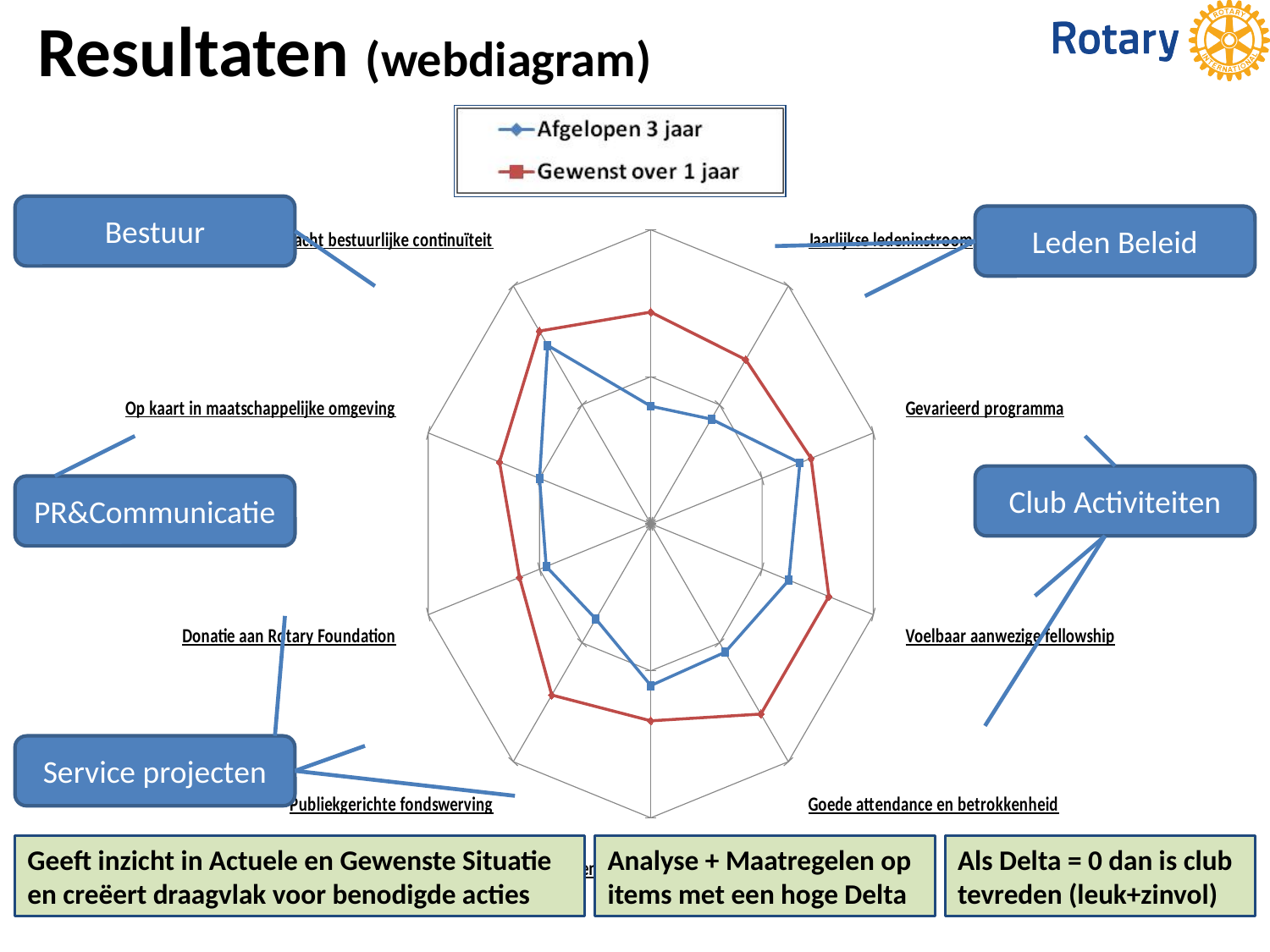
For 'Gevarieerd programma', which series has the larger value: 'Afgelopen 3 jaar' or 'Gewenst over 1 jaar'? Gewenst over 1 jaar Which colour represents the series 'Gewenst over 1 jaar'? Red For 'Op kaart in maatschappelijke omgeving', is the value for 'Afgelopen 3 jaar' larger or smaller than the value for 'Gewenst over 1 jaar'? Smaller For 'Goede attendance en betrokkenheid', which series lies further from the centre: the blue or the red series? Red (Gewenst over 1 jaar) How many series does the chart legend list? 2 What kind of chart is shown on the slide? Radar chart What are the two series named in the chart legend? Afgelopen 3 jaar and Gewenst over 1 jaar How many axes (categories) does the radar chart have? 10